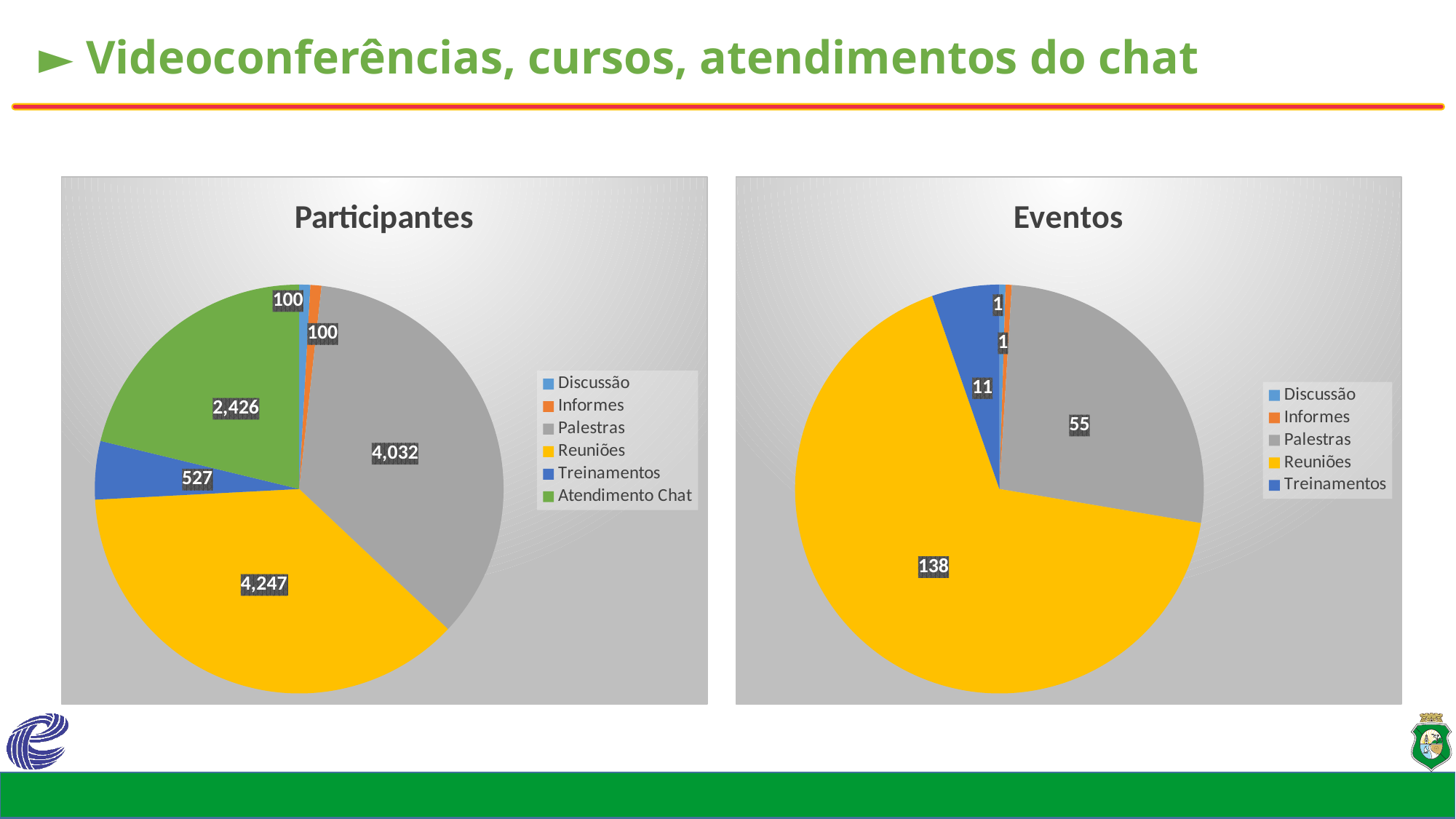
In the Eventos chart, what is the difference between Reuniões and Palestras? 83 In the Eventos chart, what share of the total do Reuniões represent? 67% In the Participantes chart, which is larger, Atendimento Chat or Treinamentos? Atendimento Chat In the Participantes chart, what is the value for Reuniões? 4,247 In the Participantes chart, what is the value for Atendimento Chat? 2,426 In the Eventos chart, what is the value for Treinamentos? 11 In the Eventos chart, which category has the largest value? Reuniões How many categories does the legend of the Participantes chart list? 6 In the Participantes chart, what is the difference between Reuniões and Palestras? 215 What type of chart is the Eventos chart? Pie chart In the Eventos chart, what is the value for Palestras? 55 In the Participantes chart, which category has the smallest value among Treinamentos, Atendimento Chat and Palestras? Treinamentos